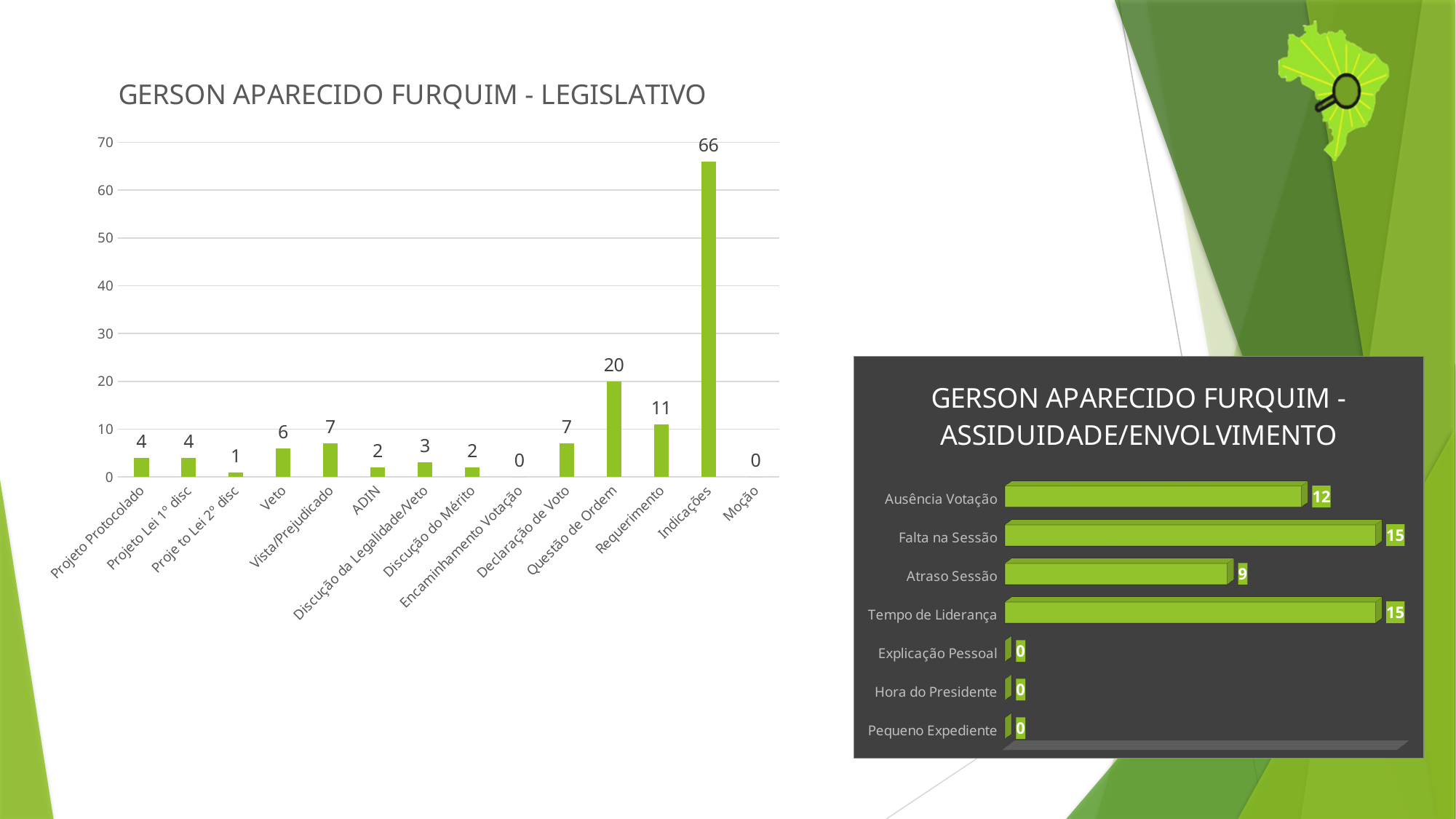
In the 'GERSON APARECIDO FURQUIM - ASSIDUIDADE/ENVOLVIMENTO' chart, what is the value for Atraso Sessão? 9 In the 'GERSON APARECIDO FURQUIM - LEGISLATIVO' chart, what is the value for Indicações? 66 In the 'GERSON APARECIDO FURQUIM - ASSIDUIDADE/ENVOLVIMENTO' chart, how many categories are listed? 7 In the 'GERSON APARECIDO FURQUIM - ASSIDUIDADE/ENVOLVIMENTO' chart, what is the value for Ausência Votação? 12 In the 'GERSON APARECIDO FURQUIM - LEGISLATIVO' chart, what is the value for Questão de Ordem? 20 What kind of chart is 'GERSON APARECIDO FURQUIM - LEGISLATIVO'? Bar chart In the 'GERSON APARECIDO FURQUIM - ASSIDUIDADE/ENVOLVIMENTO' chart, which is larger, Ausência Votação or Tempo de Liderança? Tempo de Liderança In the 'GERSON APARECIDO FURQUIM - LEGISLATIVO' chart, how many categories are shown on the x axis? 14 In the 'GERSON APARECIDO FURQUIM - LEGISLATIVO' chart, what is the difference between Indicações and Questão de Ordem? 46 In the 'GERSON APARECIDO FURQUIM - LEGISLATIVO' chart, which category has the highest value? Indicações In the 'GERSON APARECIDO FURQUIM - ASSIDUIDADE/ENVOLVIMENTO' chart, what is the difference between Falta na Sessão and Atraso Sessão? 6 In the 'GERSON APARECIDO FURQUIM - LEGISLATIVO' chart, which is larger, Requerimento or Vista/Prejudicado? Requerimento